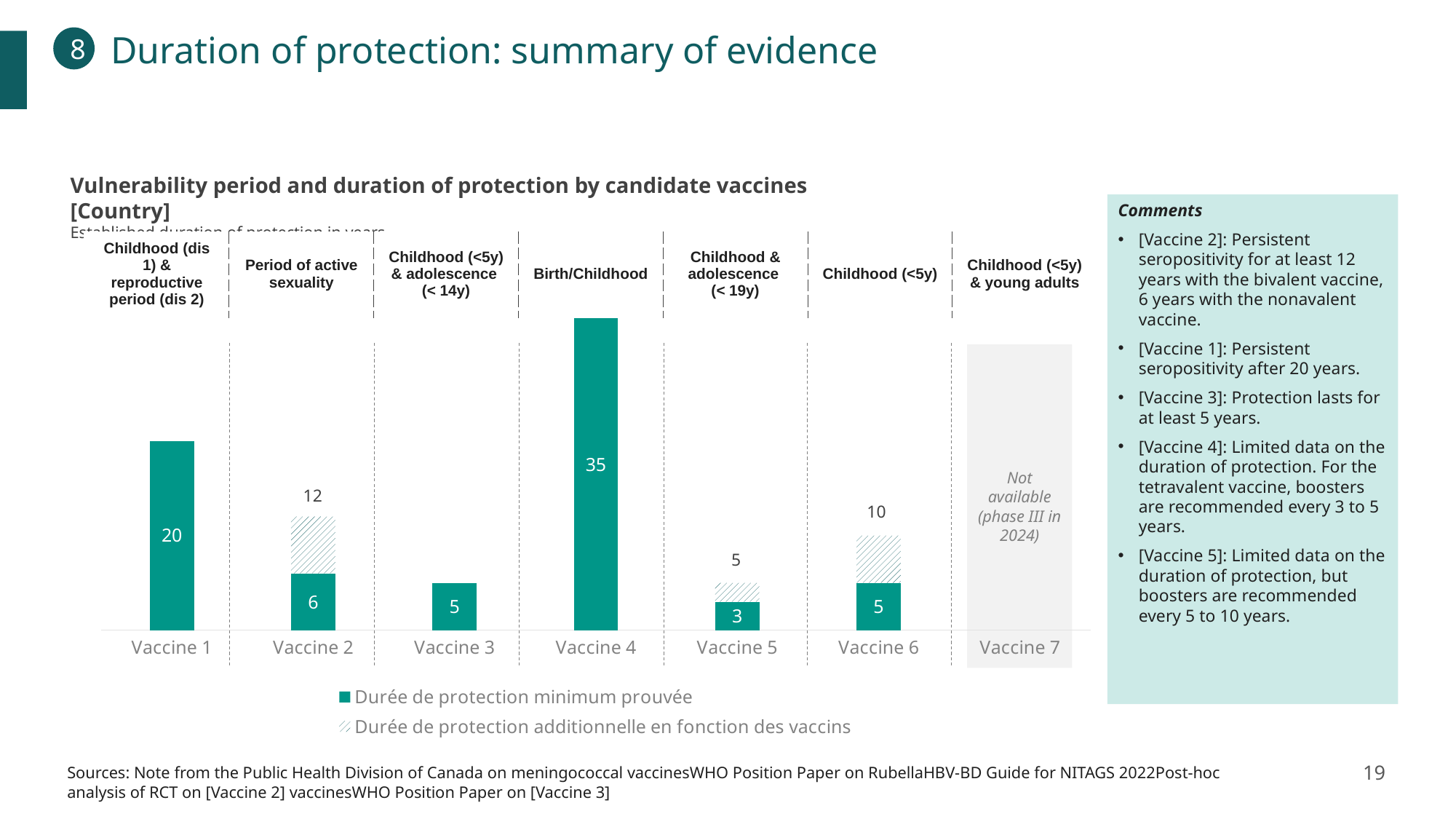
Which has a larger minimum proven duration of protection, Vaccine 3 or Vaccine 5? Vaccine 3 Which vaccine has the highest minimum proven duration of protection? Vaccine 4 What is the minimum proven duration of protection (solid bar) for Vaccine 1? 20 What kind of chart is shown on the slide? Bar chart How many series does the chart legend list? 2 How many vaccines are listed along the x axis of the chart? 7 What is the minimum proven duration of protection (solid bar) for Vaccine 2? 6 Which vaccine has the lowest minimum proven duration of protection among those with a plotted bar? Vaccine 5 What is shown in place of a bar for Vaccine 7? Not available (phase III in 2024) What value is printed at the top of the Vaccine 6 bar, including the hatched additional protection? 10 What is the minimum proven duration of protection (solid bar) for Vaccine 4? 35 What is the difference between the minimum proven duration of protection for Vaccine 4 and Vaccine 1? 15